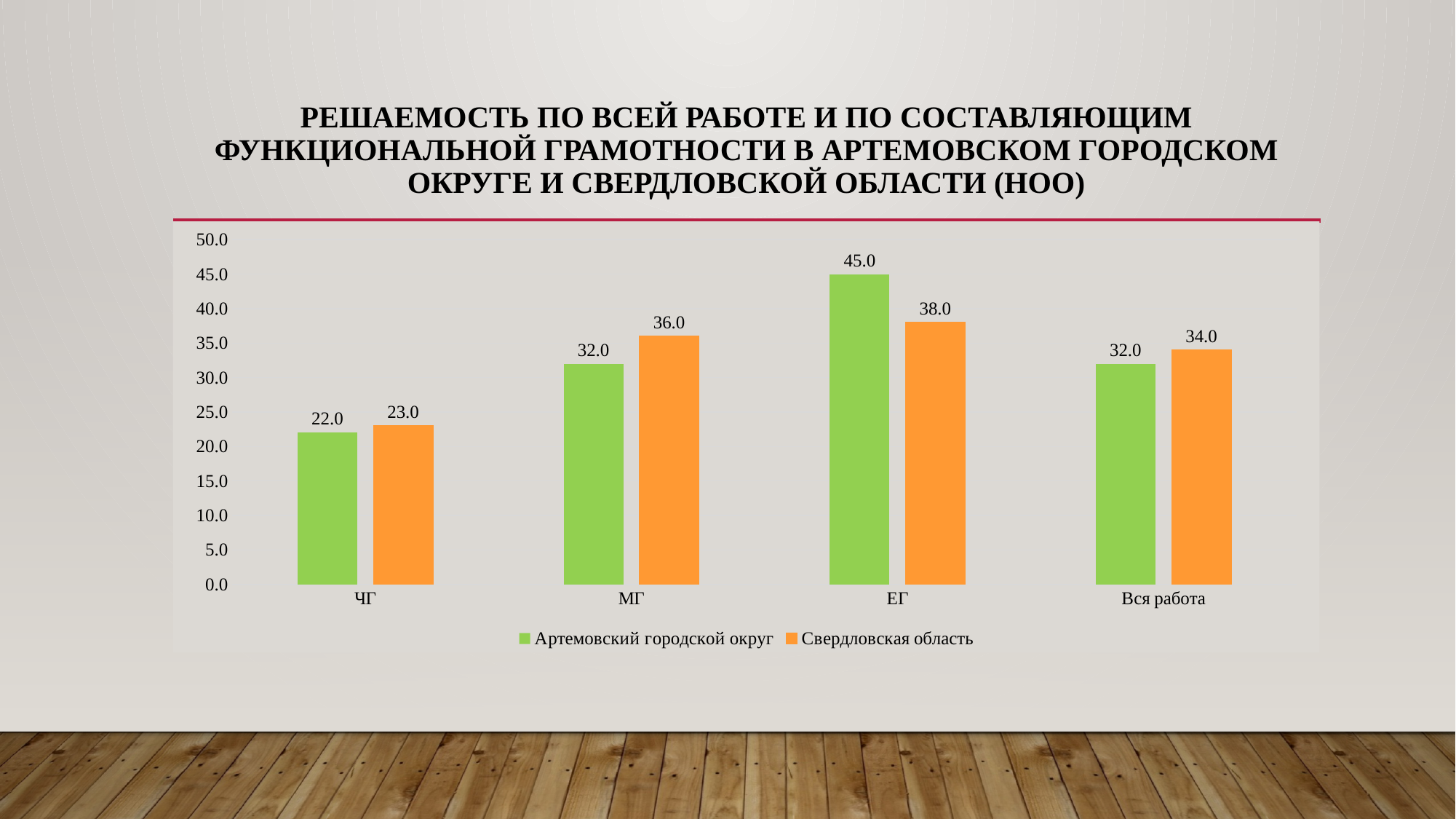
How many categories are shown on the x axis? 4 What is the value for Артемовский городской округ in the ЧГ category? 22.0 What kind of chart is shown on the slide? Bar chart In the МГ category, which series has the larger value: Артемовский городской округ or Свердловская область? Свердловская область What is the value for Свердловская область in the Вся работа category? 34.0 Which colour represents Свердловская область in the chart? Orange Which category has the lowest value for Свердловская область? ЧГ What is the value for Артемовский городской округ in the ЕГ category? 45.0 How many series does the legend list? 2 Which category has the highest value for Артемовский городской округ? ЕГ What is the difference between Артемовский городской округ and Свердловская область in the ЕГ category? 7.0 What is the value for Свердловская область in the МГ category? 36.0